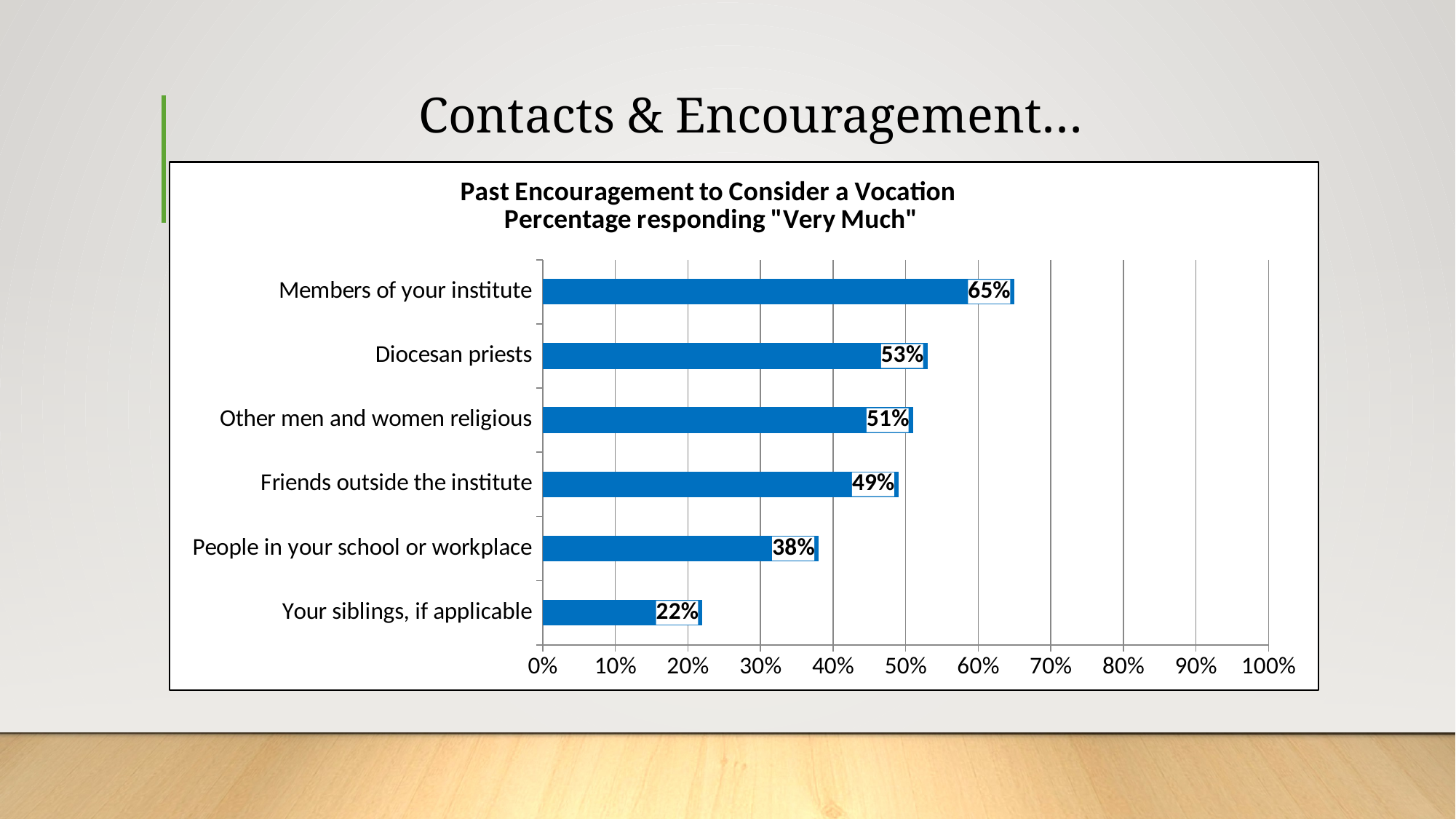
Which is larger: Other men and women religious or People in your school or workplace? Other men and women religious What is the title of the chart? Past Encouragement to Consider a Vocation Percentage responding "Very Much" What is the value for Your siblings, if applicable? 22% How many categories are shown in the chart? 6 What is the value for Diocesan priests? 53% What is the value for People in your school or workplace? 38% What is the difference between Members of your institute and Diocesan priests? 12% What percentage responded "Very Much" for Members of your institute? 65% What is the difference between Friends outside the institute and Your siblings, if applicable? 27% Which category has the highest percentage? Members of your institute Which category has the lowest percentage? Your siblings, if applicable What kind of chart is shown on the slide? Bar chart